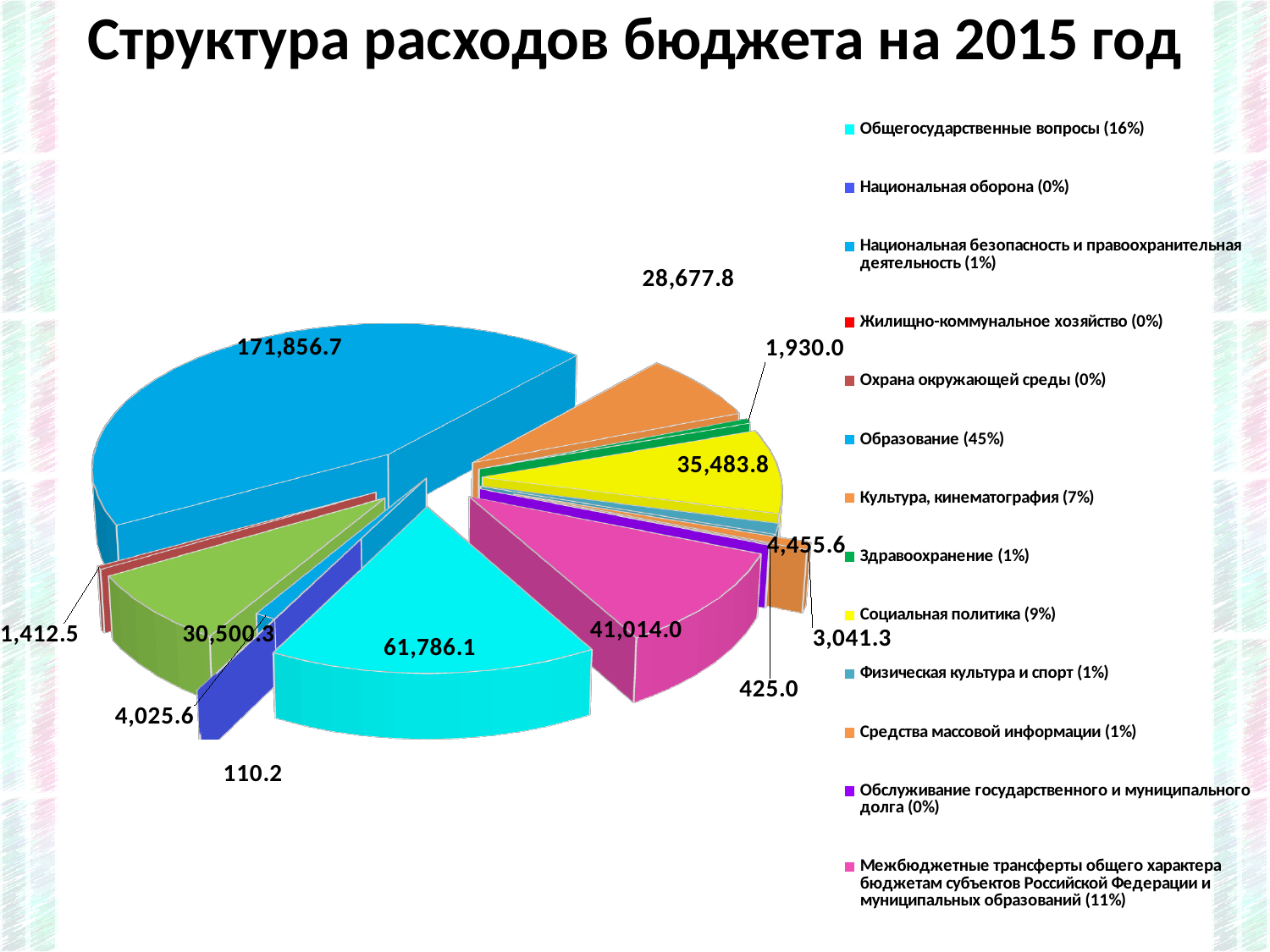
What share of the pie does Образование represent according to the legend? 45% What is the title of the chart? Структура расходов бюджета на 2015 год What kind of chart is shown on the slide? pie chart What is the value labeled for Образование? 171,856.7 Which is larger: the value for Межбюджетные трансферты общего характера or for Социальная политика? Межбюджетные трансферты общего характера What is the value labeled for Общегосударственные вопросы? 61,786.1 Which category has the largest slice of the pie? Образование What is the value labeled for Культура, кинематография? 28,677.8 What share of the pie does Социальная политика represent according to the legend? 9% How many categories does the legend list? 13 What is the difference between the values for Образование and Общегосударственные вопросы? 110,070.6 What is the smallest value labeled on the chart? 110.2